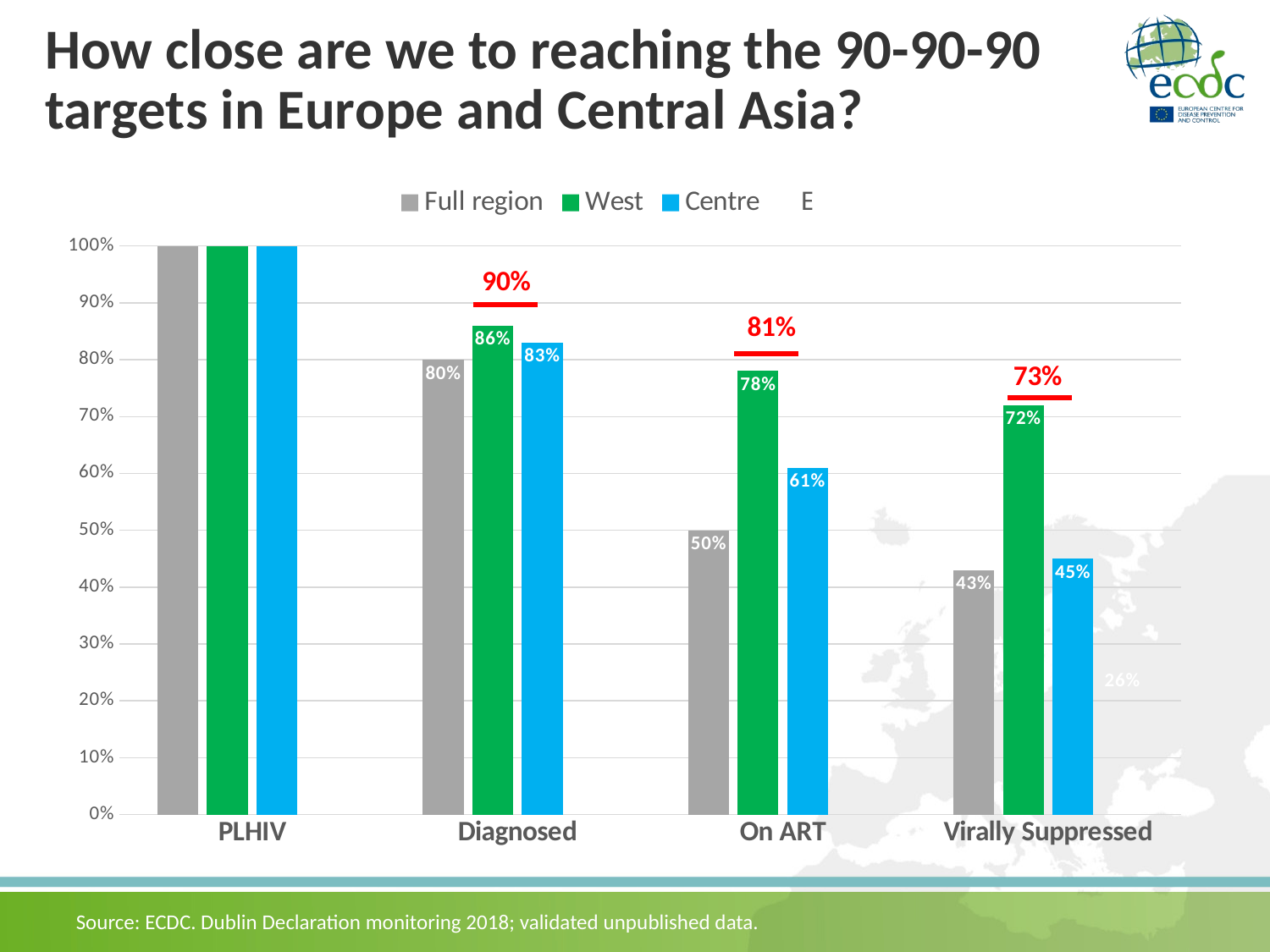
What kind of chart is shown on the slide? Bar chart Which series has the highest value for Diagnosed? West How many categories are shown on the x axis? 4 Which is larger for the Centre series: the Diagnosed value or the On ART value? Diagnosed What is the West value for Diagnosed? 86% What is the Full region value for Diagnosed? 80% What is the difference between the West and Centre values for On ART? 17 percentage points What is the Centre value for Virally Suppressed? 45% Do the Full region values rise or fall from Diagnosed to Virally Suppressed? Fall What red target value is shown above the On ART bars? 81% What is the Full region value for On ART? 50%